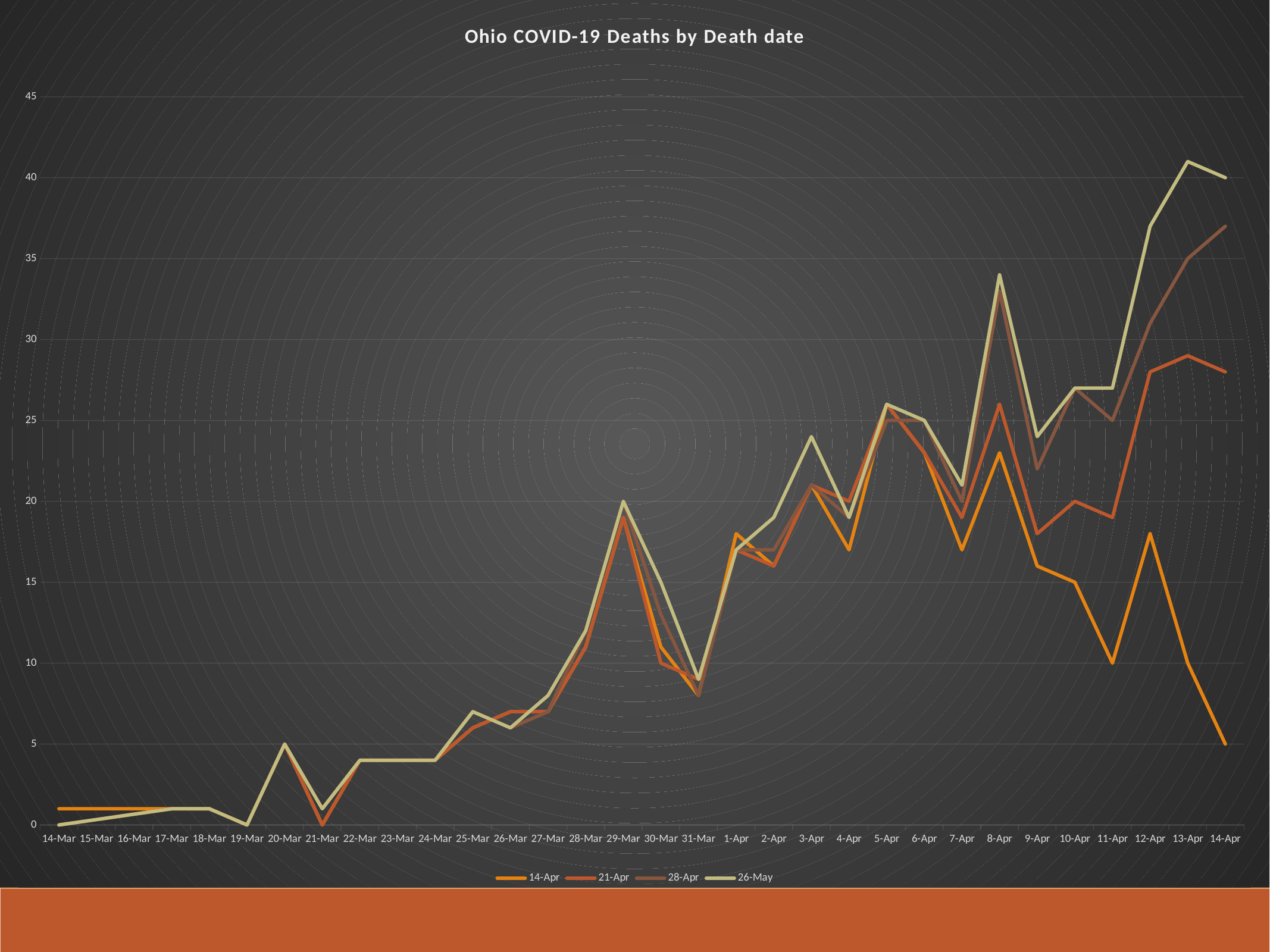
How many dates are shown along the x axis? 32 How many series does the legend list? 4 What is the title of the chart? Ohio COVID-19 Deaths by Death date Is the value of the 26-May series on 13-Apr greater or less than 40? greater What is the value of the 14-Apr series on 14-Apr? 5 What is the value of the 26-May series on 14-Apr? 40 On 8-Apr, which series has the larger value, 26-May or 21-Apr? 26-May What is the value of the 26-May series on 20-Mar? 5 Which series has the lowest value on 14-Apr? 14-Apr Is the value of the 21-Apr series on 13-Apr greater or less than 25? greater Which series has the highest value on 14-Apr? 26-May What kind of chart is shown on the slide? line chart